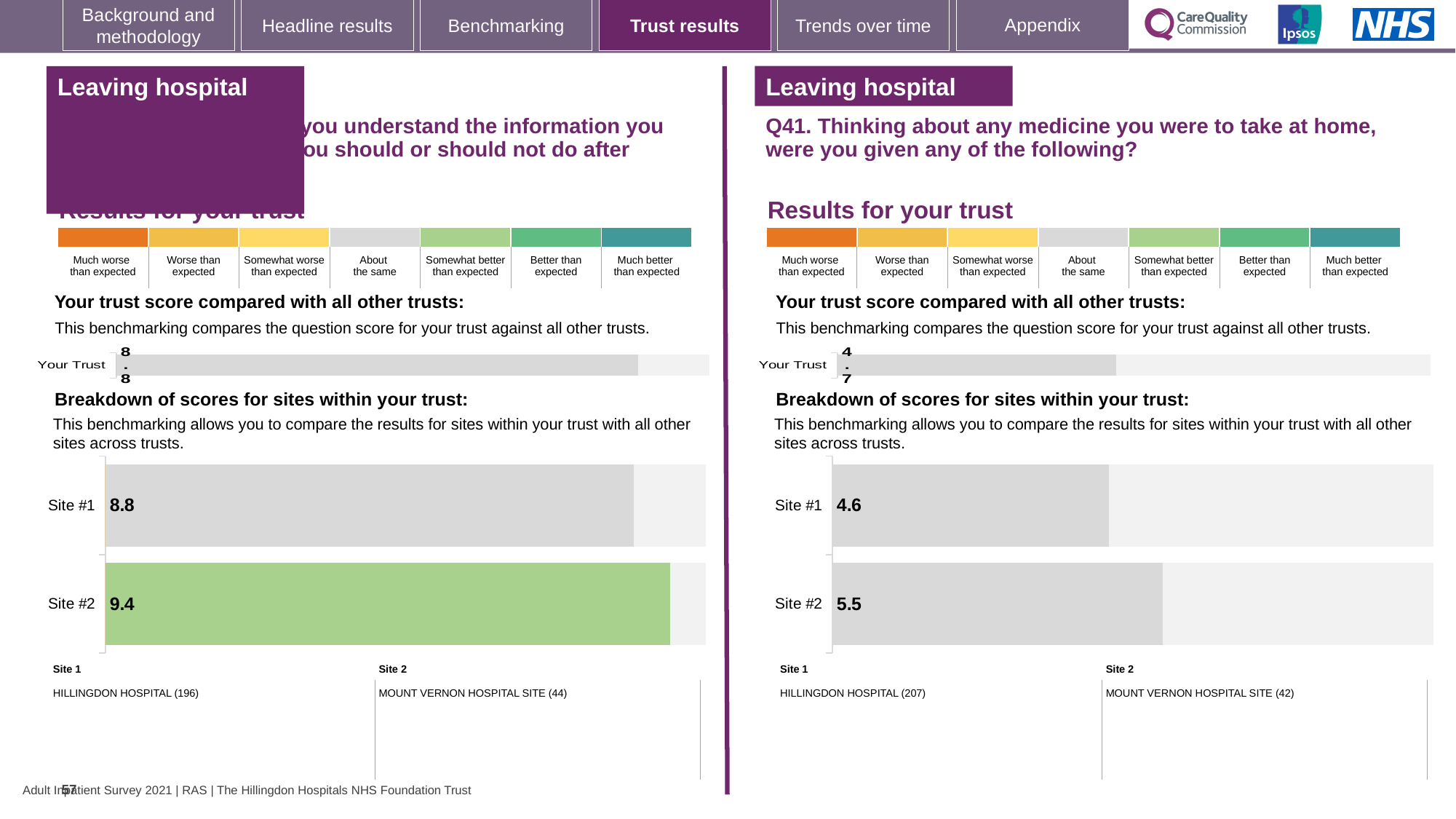
What type of chart is used for the site breakdown on the left-hand side? Bar chart On the right-hand site breakdown chart (Q41), which site has the lower score? Site #1 On the left-hand chart, what is the score for Site #2? 9.4 On the right-hand side (Q41), what is the 'Your Trust' score? 4.7 On the right-hand chart (Q41), what is the score for Site #1? 4.6 On the left-hand side, what is the 'Your Trust' score? 8.8 On the left-hand site breakdown chart, which site has the higher score? Site #2 On the right-hand site breakdown chart (Q41), what is the difference between the Site #2 and Site #1 scores? 0.9 How many sites are shown in the right-hand site breakdown chart (Q41)? 2 On the left-hand chart, what is the score for Site #1? 8.8 On the right-hand chart (Q41), what is the score for Site #2? 5.5 On the left-hand site breakdown chart, what is the difference between the Site #2 and Site #1 scores? 0.6